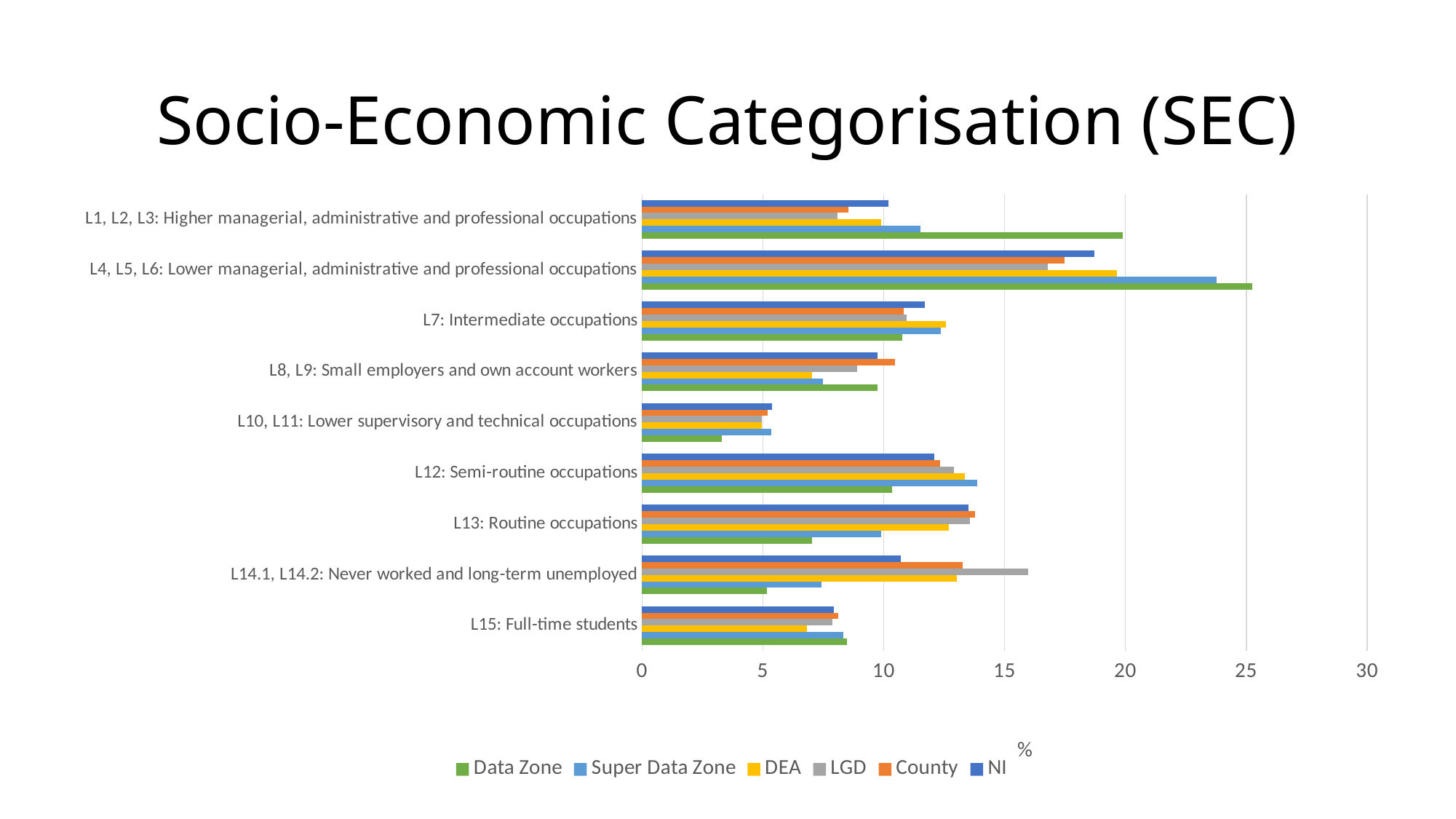
For L4, L5, L6: Lower managerial, administrative and professional occupations, which is larger: the Data Zone value or the Super Data Zone value? Data Zone For the Data Zone series, which category has the highest value? L4, L5, L6: Lower managerial, administrative and professional occupations What unit is shown on the horizontal axis of the chart? % How many series does the legend list? 6 For L13: Routine occupations, which is larger: the Data Zone value or the NI value? NI Is the LGD value for L14.1, L14.2: Never worked and long-term unemployed greater or less than 15? greater Is the Data Zone value for L10, L11: Lower supervisory and technical occupations greater or less than 5? less What kind of chart is shown on the slide? Bar chart Is the Super Data Zone value for L4, L5, L6: Lower managerial, administrative and professional occupations greater or less than 20? greater For the Data Zone series, which category has the lowest value? L10, L11: Lower supervisory and technical occupations How many occupation categories are plotted on the chart? 9